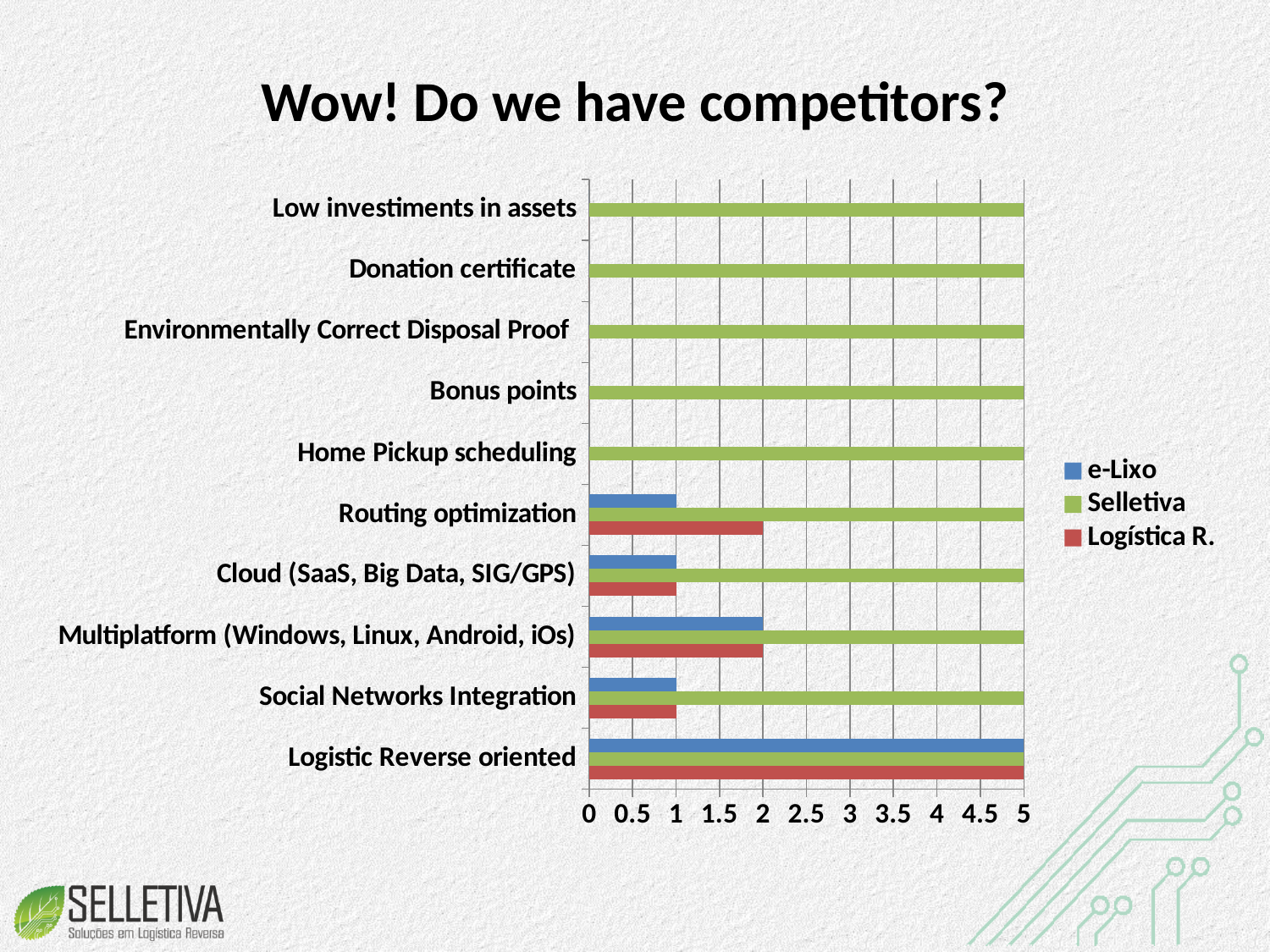
Which series is shown in green in the legend? Selletiva What is the title of the slide? Wow! Do we have competitors? How many series does the legend list? 3 How many categories are shown on the chart? 10 What is the difference between the Selletiva and e-Lixo values for Social Networks Integration? 4 What is the value for e-Lixo in the Multiplatform (Windows, Linux, Android, iOs) category? 2 What is the value for Selletiva in the Bonus points category? 5 Is the value for Selletiva in Home Pickup scheduling greater or less than 3? greater What is the value for Logística R. in the Routing optimization category? 2 Which is larger for Routing optimization, the e-Lixo value or the Logística R. value? Logística R. What is the value for e-Lixo in the Logistic Reverse oriented category? 5 What kind of chart is shown on the slide? bar chart